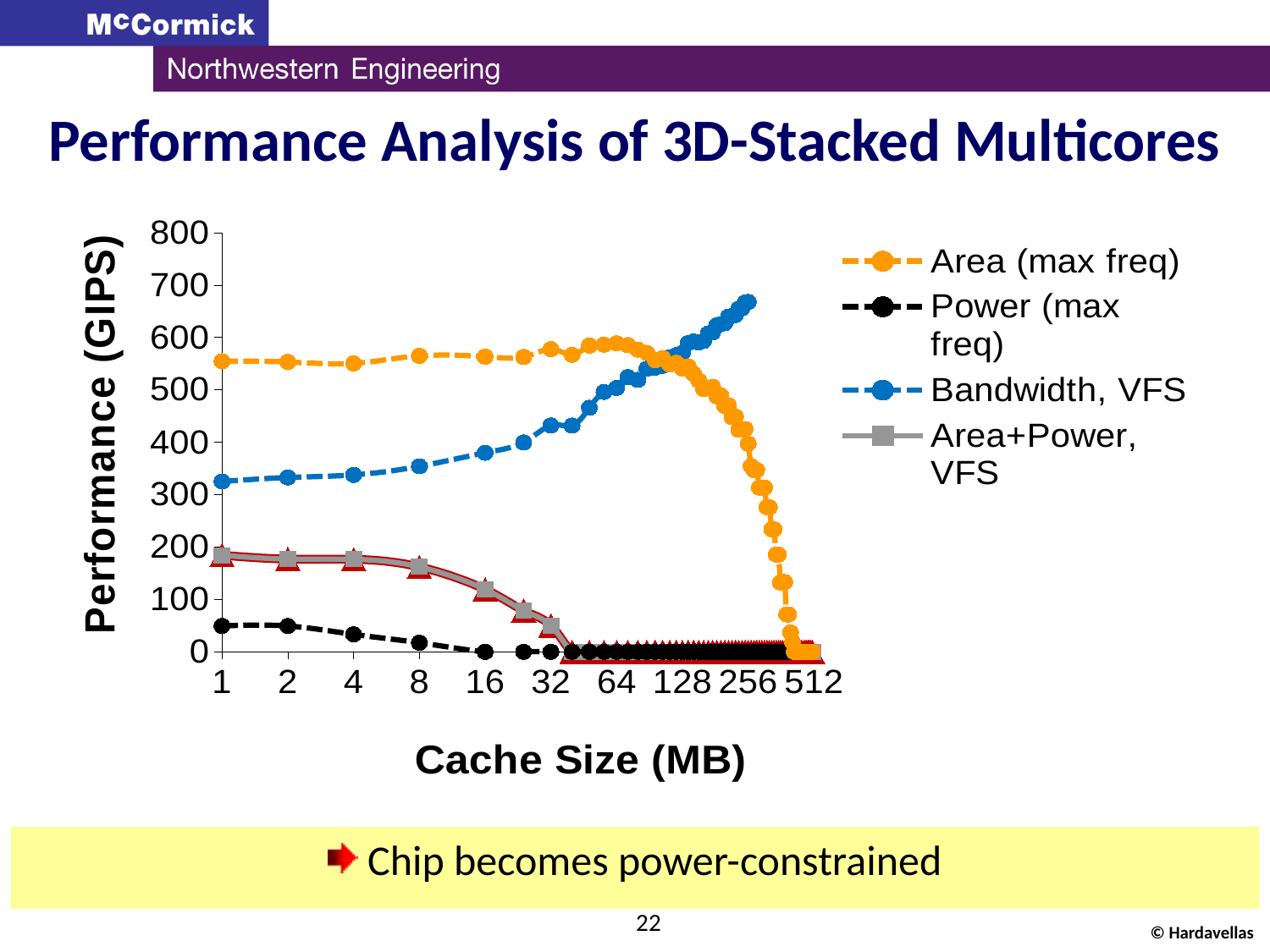
Is the value for Area (max freq) at a cache size of 1 MB greater or less than 500? greater At a cache size of 256 MB, which is larger: Bandwidth, VFS or Area (max freq)? Bandwidth, VFS Is the value for Area+Power, VFS at a cache size of 1 MB greater or less than 200? less What is the label of the chart's vertical axis? Performance (GIPS) What kind of chart is shown on the slide? line chart Is the value for Power (max freq) at a cache size of 1 MB greater or less than 100? less At a cache size of 1 MB, which is larger: Area (max freq) or Bandwidth, VFS? Area (max freq) What is the title of the slide containing the chart? Performance Analysis of 3D-Stacked Multicores Which series has the lowest value at a cache size of 1 MB? Power (max freq) Does the Bandwidth, VFS series rise or fall as cache size increases? rise How many series does the chart's legend list? 4